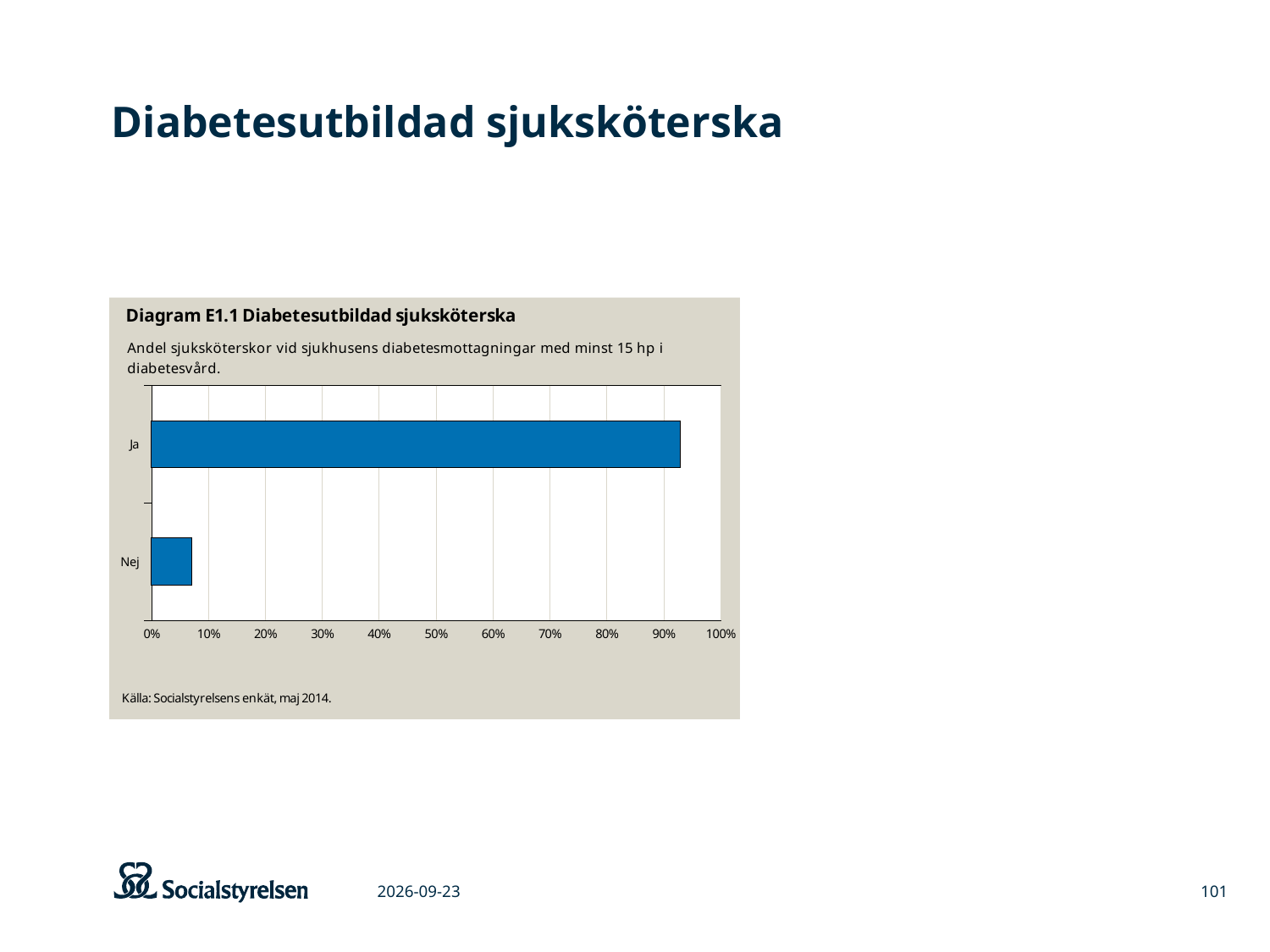
What is the title of the diagram? Diagram E1.1 Diabetesutbildad sjuksköterska Which category has the highest value? Ja Is the value for Nej greater or less than 10%? less Which category has the lowest value? Nej Is the value for Nej greater or less than 20%? less What kind of chart is shown on the slide? bar chart Which is larger, the value for Ja or the value for Nej? Ja How many categories are plotted in the chart? 2 Is the value for Ja greater or less than 90%? greater What source is cited below the chart? Socialstyrelsens enkät, maj 2014.